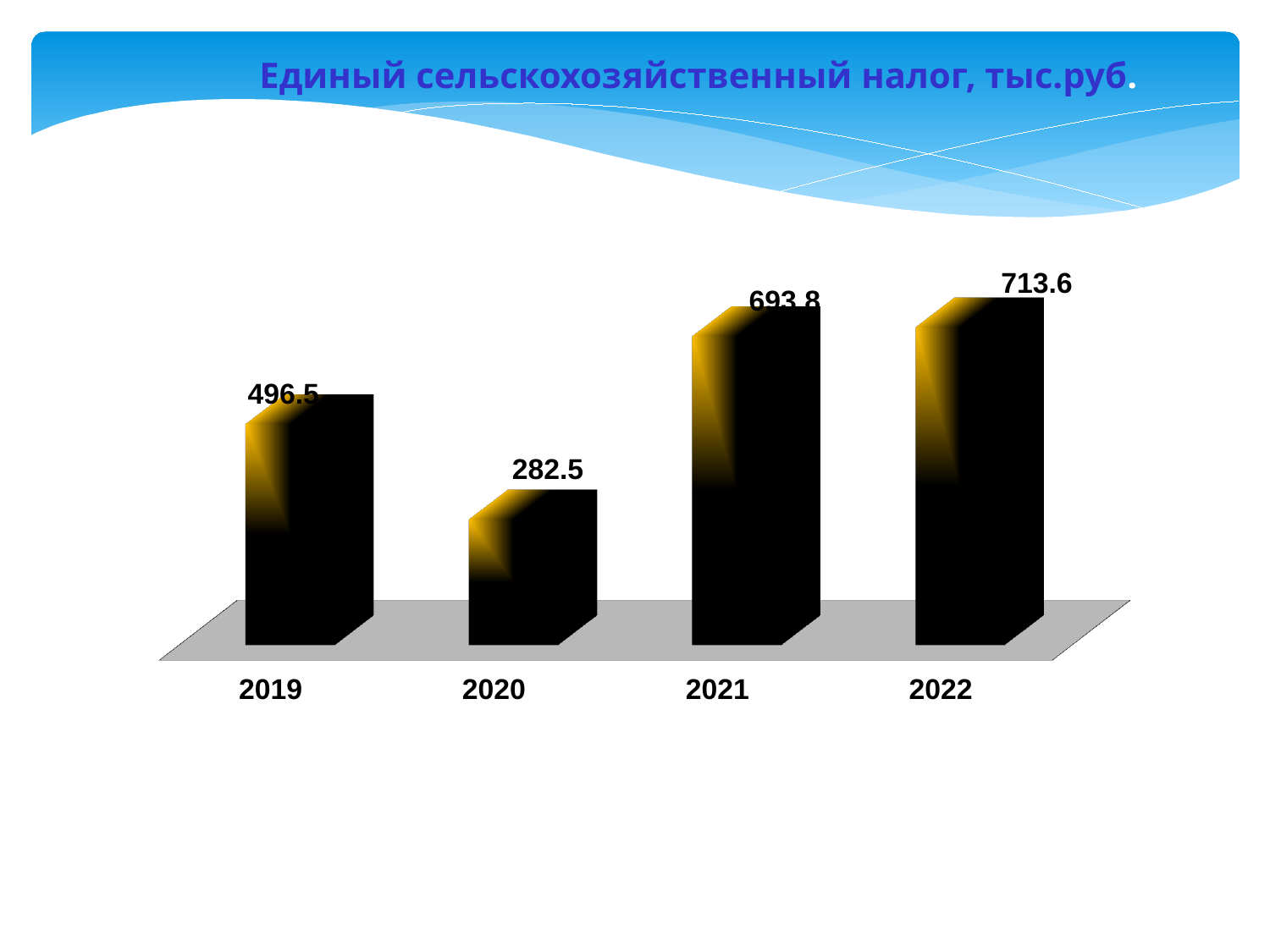
Which year has the lowest value? 2020 What kind of chart is shown on the slide? bar chart Which year has the highest value? 2022 What is the value for 2020? 282.5 How many years are shown on the chart? 4 What is the value for 2022? 713.6 What is the value for 2021? 693.8 What is the title of the chart? Единый сельскохозяйственный налог, тыс.руб. What is the difference between the values for 2021 and 2020? 411.3 What is the value for 2019? 496.5 Which is larger, the value for 2019 or the value for 2020? 2019 What is the difference between the values for 2022 and 2019? 217.1